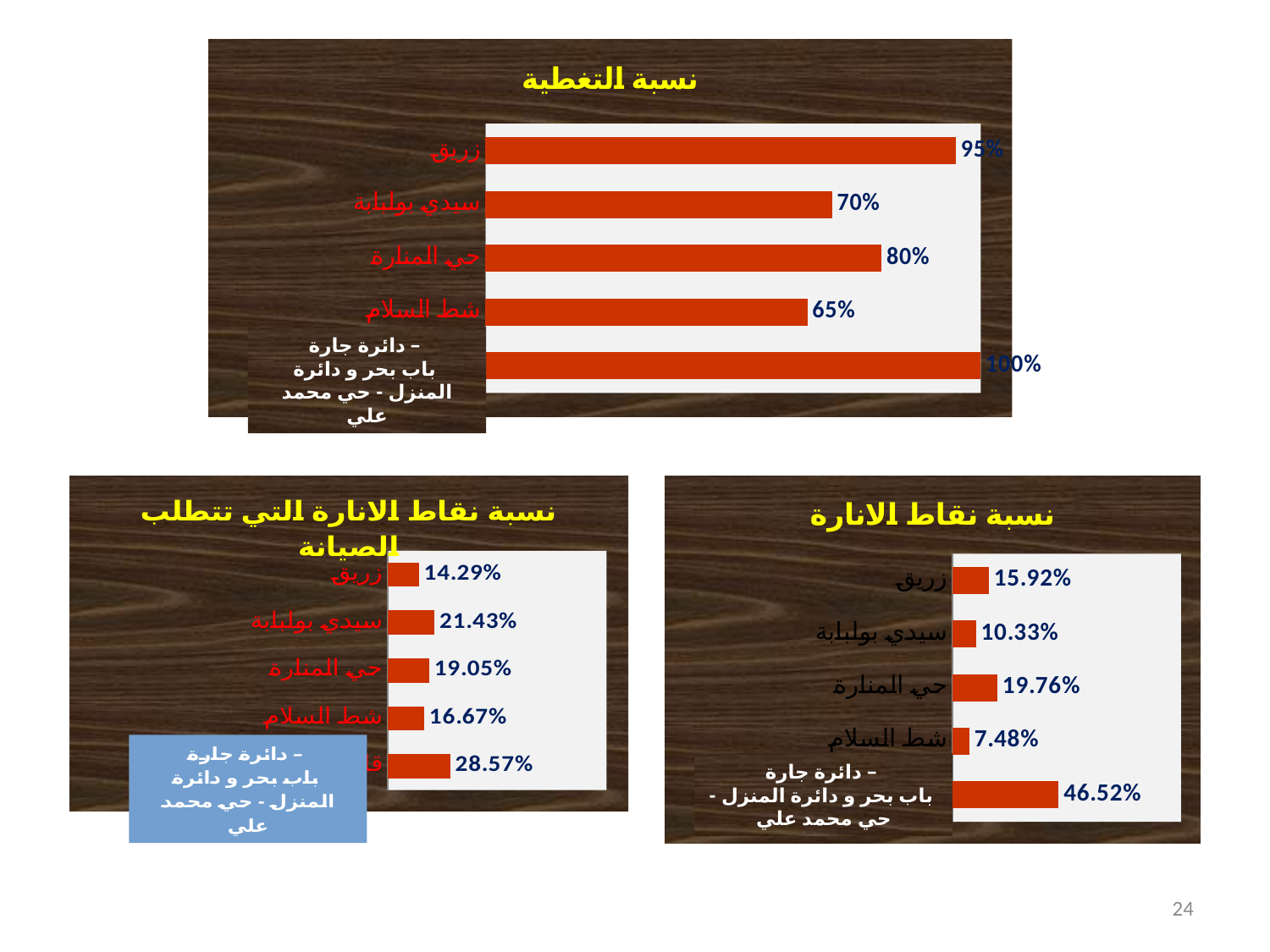
What kind of chart is the top chart titled نسبة التغطية? bar chart In the bottom-left chart titled نسبة نقاط الانارة التي تتطلب الصيانة, what is the value for حي المنارة? 19.05% In the top chart titled نسبة التغطية, what is the value for زريق? 95% In the top chart titled نسبة التغطية, how many categories are plotted? 5 In the top chart titled نسبة التغطية, which category has the lowest value? شط السلام In the bottom-left chart titled نسبة نقاط الانارة التي تتطلب الصيانة, which category has the lowest value? زريق In the top chart titled نسبة التغطية, what is the difference between the values for حي المنارة and سيدي بولبابة? 10% In the bottom-right chart titled نسبة نقاط الانارة, which is larger, the value for زريق or the value for سيدي بولبابة? زريق How many charts are shown on the slide? 3 In the bottom-right chart titled نسبة نقاط الانارة, which category has the highest value? دائرة جارة باب بحر و دائرة المنزل - حي محمد علي In the bottom-right chart titled نسبة نقاط الانارة, what is the value for شط السلام? 7.48% In the bottom-left chart titled نسبة نقاط الانارة التي تتطلب الصيانة, what is the value for سيدي بولبابة? 21.43%